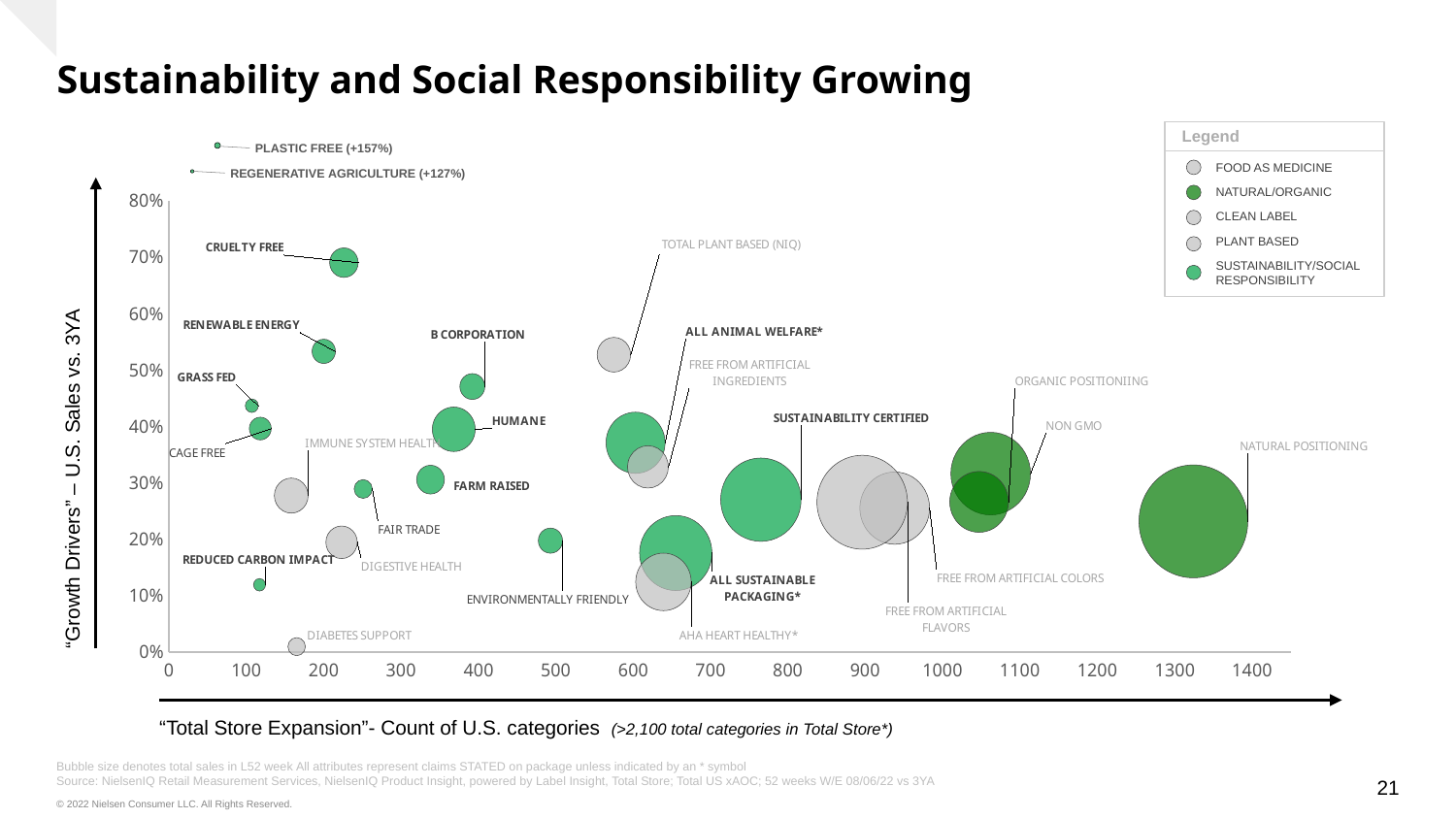
Which attribute is plotted lowest on the y axis? DIABETES SUPPORT Is the count of U.S. categories for NATURAL POSITIONING greater or less than 1200? greater Is the growth value for REDUCED CARBON IMPACT greater or less than 20%? less Is the growth value for CRUELTY FREE greater or less than 60%? greater What is the title of the chart? Sustainability and Social Responsibility Growing Which attribute is plotted furthest to the right on the x axis? NATURAL POSITIONING Which has the higher growth value, CRUELTY FREE or GRASS FED? CRUELTY FREE What growth figure is shown for REGENERATIVE AGRICULTURE? +127% What kind of chart is shown on the slide? Bubble chart What growth figure is shown for PLASTIC FREE? +157% How many series does the legend list? 5